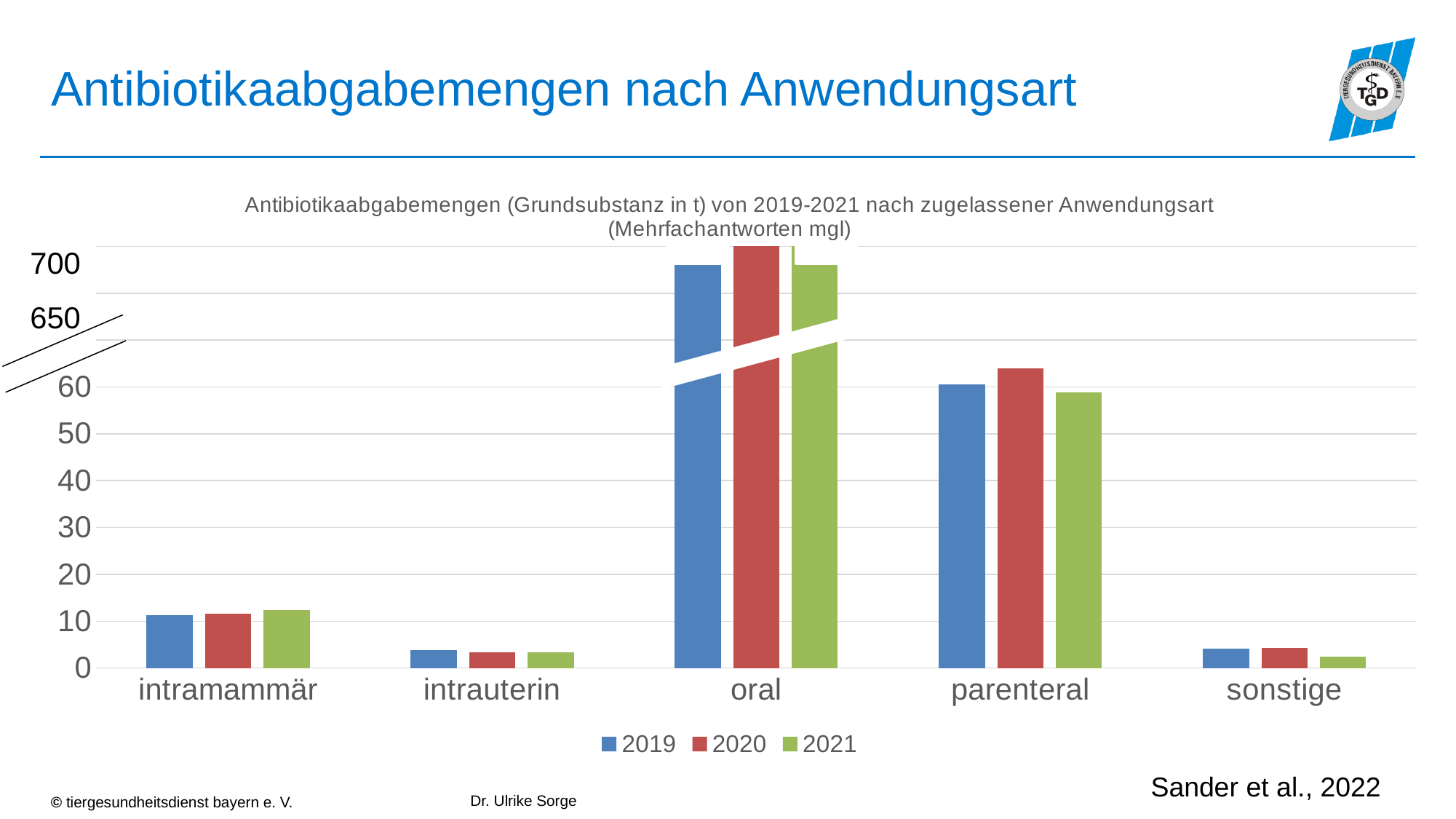
Which is larger in 2021, intramammär or intrauterin? intramammär Which years are listed in the legend? 2019, 2020, 2021 Is the value for intramammär in 2021 greater or less than 10? greater For parenteral, which year has the larger value, 2020 or 2021? 2020 What kind of chart is shown on the slide? bar chart How many application types (categories) are shown on the x axis? 5 Is the value for sonstige in 2021 greater or less than 10? less Is the value for parenteral in 2019 greater or less than 50? greater Which application type has the highest antibiotic quantities? oral How many series does the legend list? 3